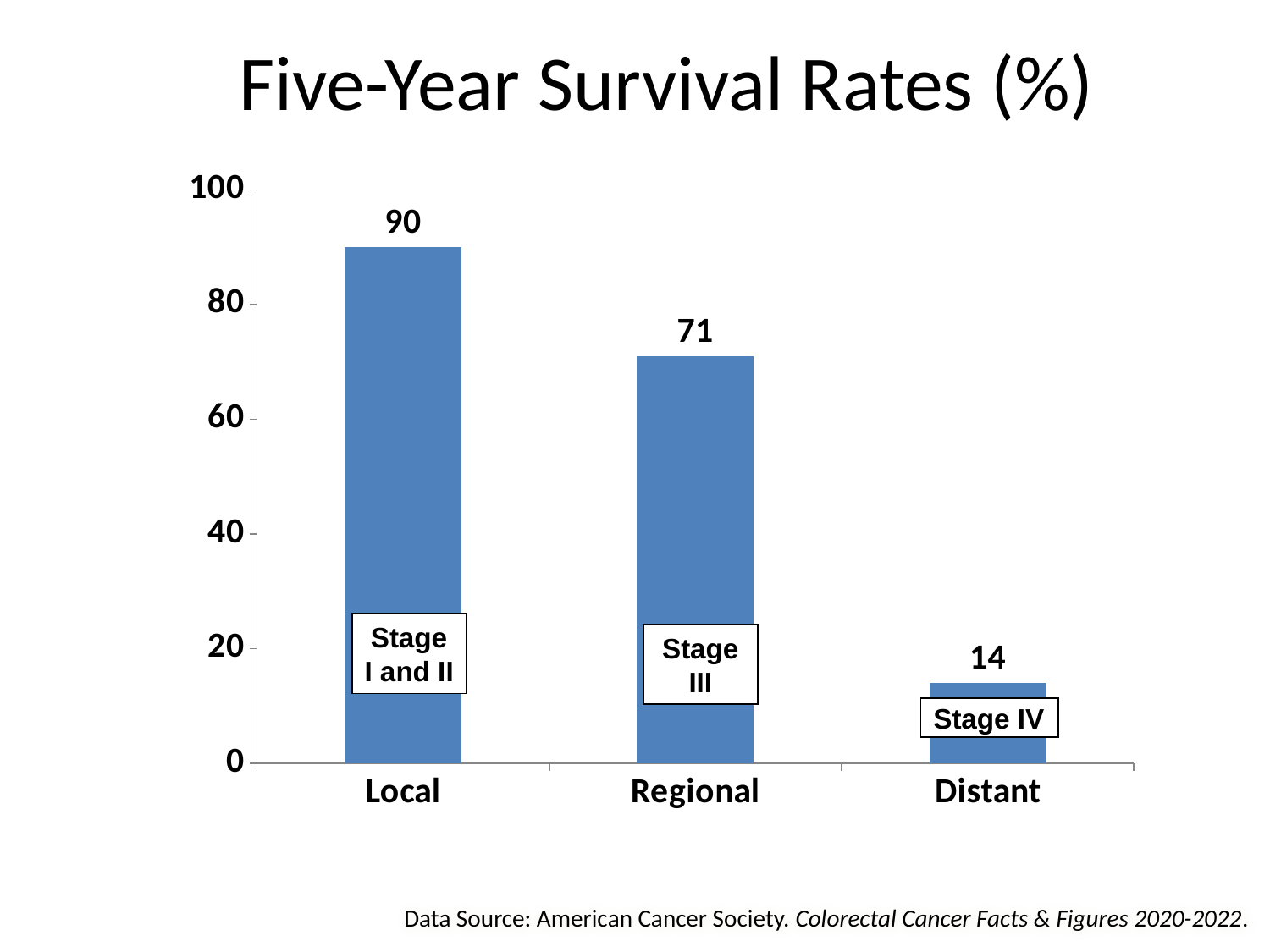
What is the difference between the survival rates for Regional and Distant? 57 What is the five-year survival rate for Local? 90 Which is larger, the survival rate for Regional or for Distant? Regional What is the difference between the survival rates for Local and Regional? 19 How many categories are shown on the x axis? 3 What is the five-year survival rate for Distant? 14 What is the five-year survival rate for Regional? 71 What kind of chart is shown on the slide? bar chart Is the value for Distant greater or less than 20? less Which category has the highest five-year survival rate? Local Which category has the lowest five-year survival rate? Distant Which stage label is shown on the Distant bar? Stage IV